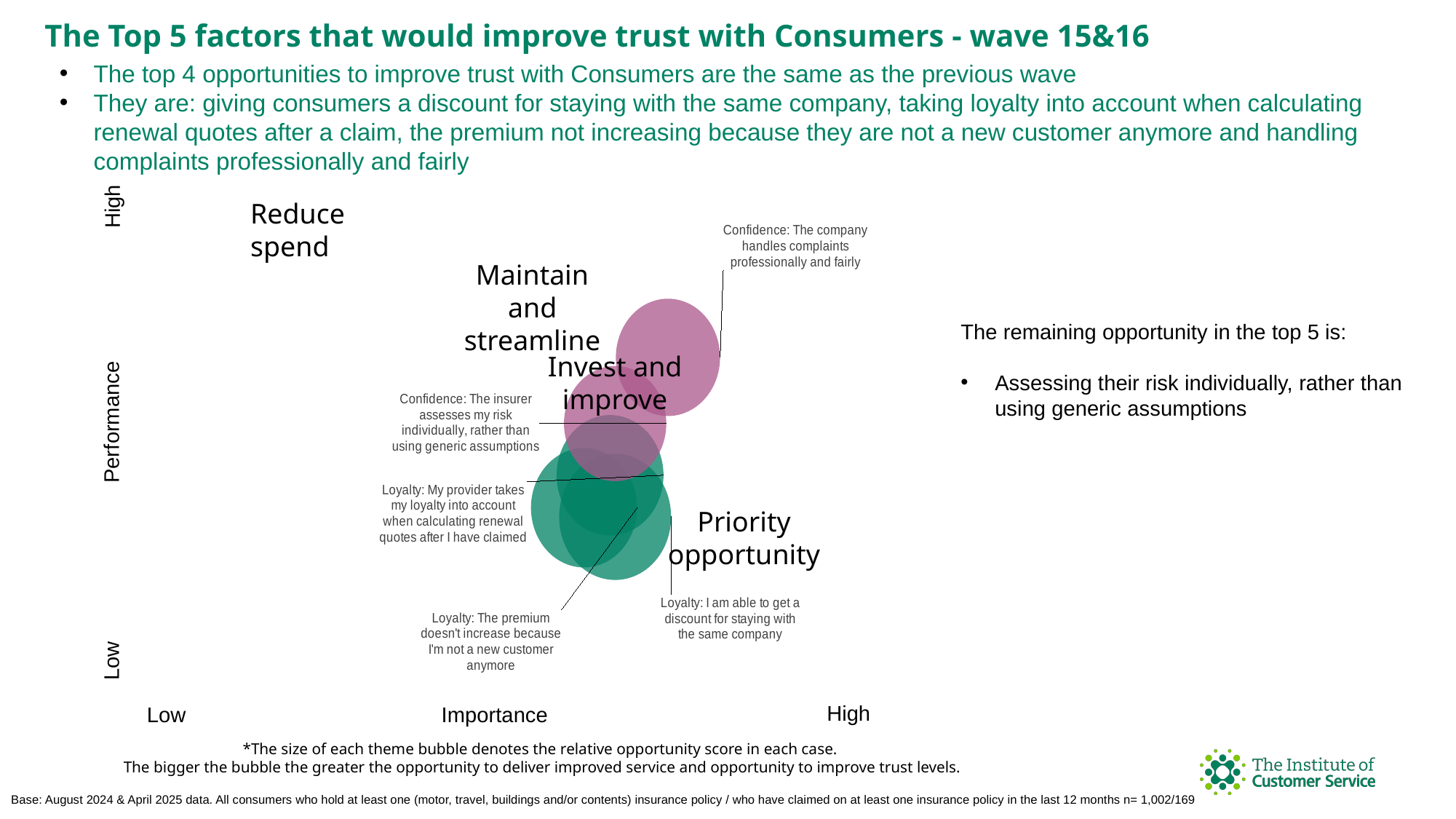
What is the label of the horizontal axis of the chart? Importance How many of the plotted bubbles are labelled as 'Confidence' factors? 2 How many of the plotted bubbles are labelled as 'Loyalty' factors? 3 Which bubble is further right on the Importance axis: 'Confidence: The company handles complaints professionally and fairly' or 'Loyalty: My provider takes my loyalty into account when calculating renewal quotes after I have claimed'? Confidence: The company handles complaints professionally and fairly What is the label of the vertical axis of the chart? Performance Which factor's bubble is positioned highest on the Performance axis? Confidence: The company handles complaints professionally and fairly Which quadrant label appears in the top-left area of the chart? Reduce spend Which bubble is higher on the Performance axis: 'Confidence: The company handles complaints professionally and fairly' or 'Loyalty: The premium doesn't increase because I'm not a new customer anymore'? Confidence: The company handles complaints professionally and fairly What kind of chart is shown on the slide? Bubble chart How many bubbles are plotted on the chart? 5